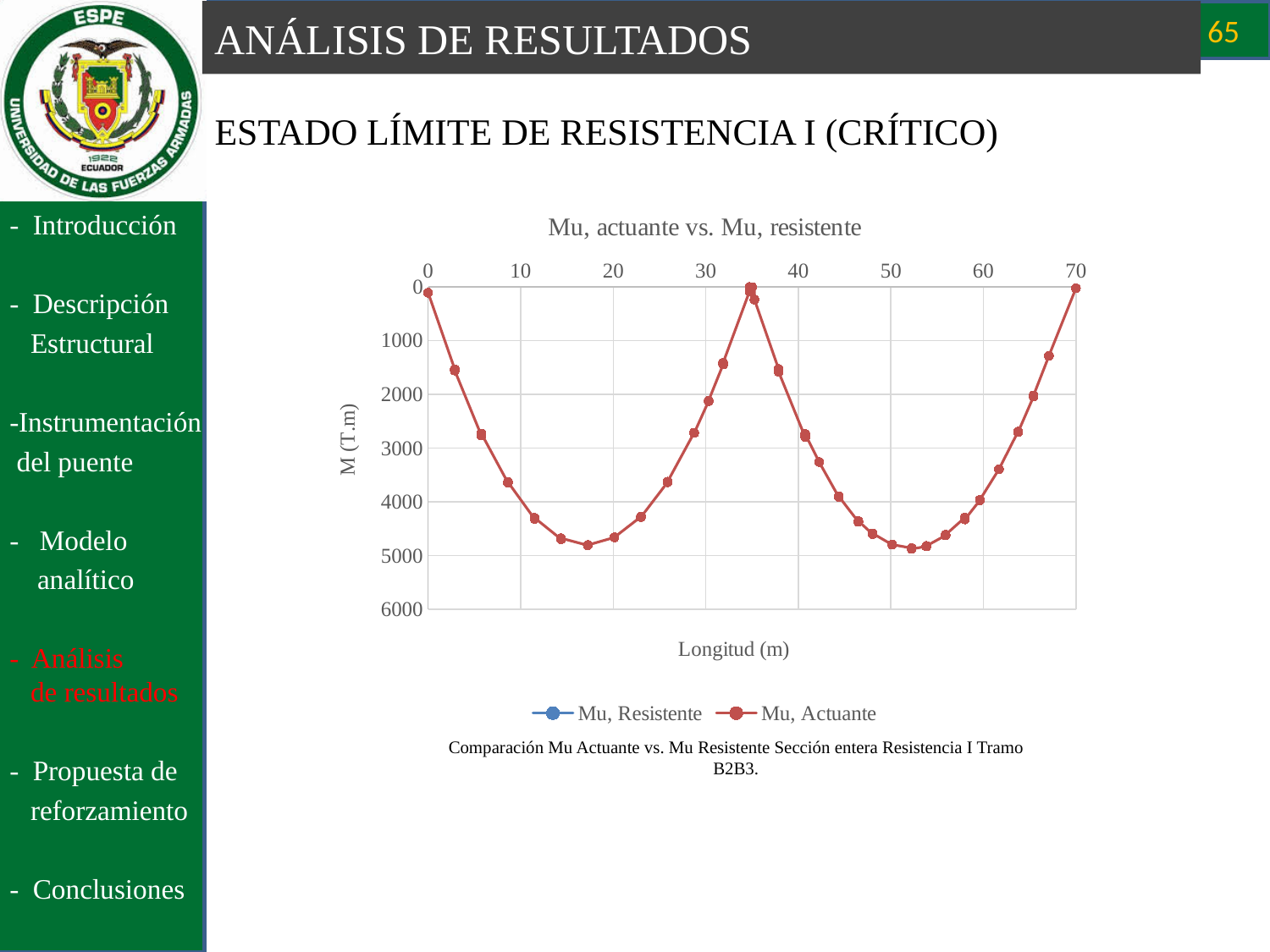
What kind of chart is shown on the slide? line chart Is the value of Mu, Actuante at Longitud 40 m greater or less than 2000? greater How many series does the chart legend list? 2 Is the value of Mu, Actuante at Longitud 20 m greater or less than 4000? greater What is the title of the chart? Mu, actuante vs. Mu, resistente Between Longitud 0 m and 10 m, does the plotted Mu, Actuante value increase or decrease? increase Is the value of Mu, Actuante at Longitud 40 m greater or less than 3000? less What is the label of the x axis of the chart? Longitud (m)